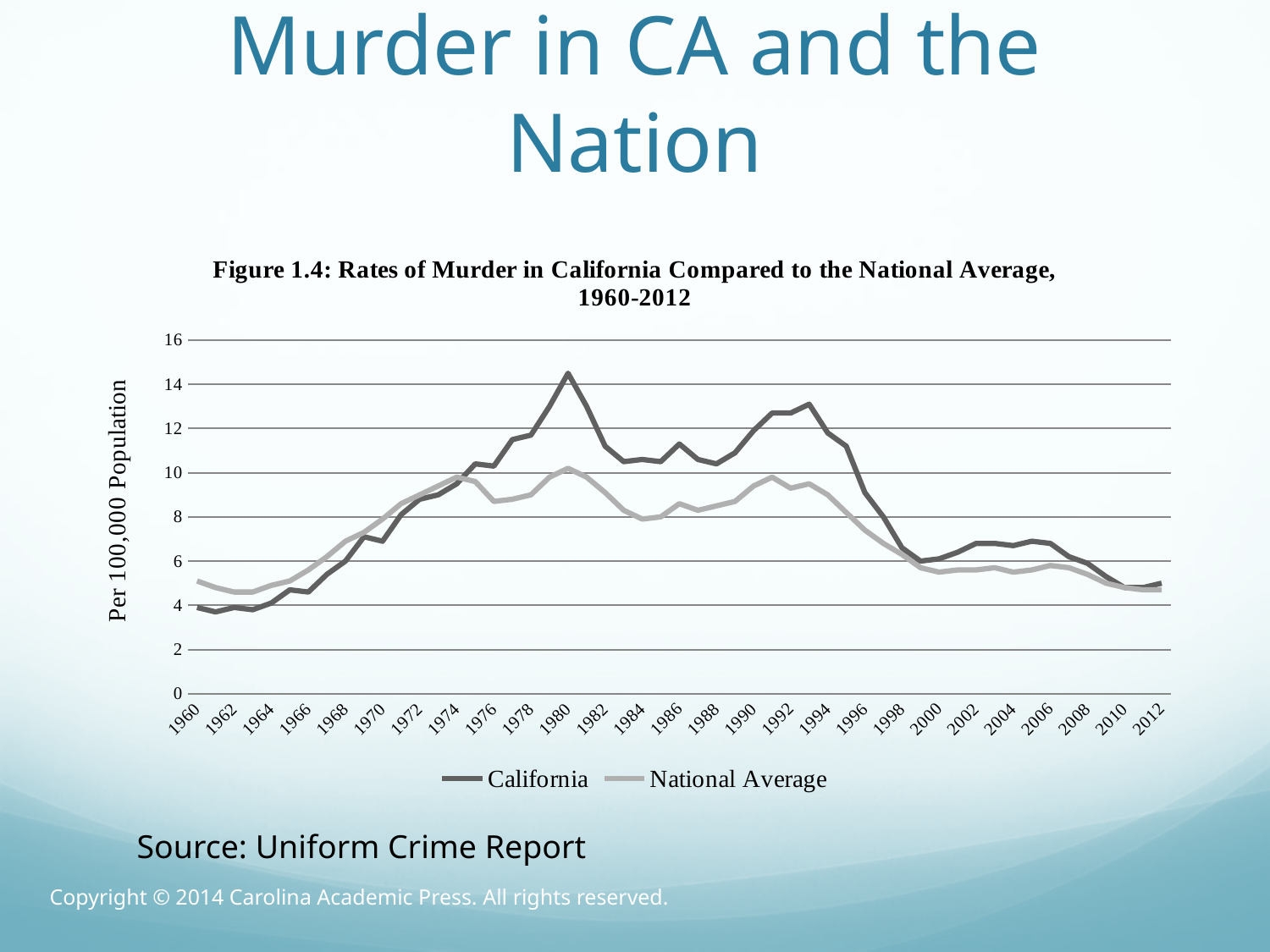
What are the two series named in the legend? California and National Average In 1980, which series has the higher value, California or National Average? California Is the California value in 1992 greater or less than 12? greater How many series does the legend list? 2 In 1960, which series has the higher value, California or National Average? National Average Between 1994 and 2000, does the California line rise or fall? fall What kind of chart is shown on the slide? line chart Is the National Average value in 1960 greater or less than 6? less In which year does the California line reach its highest value? 1980 What is the label on the vertical axis? Per 100,000 Population Is the National Average value in 2012 greater or less than 6? less